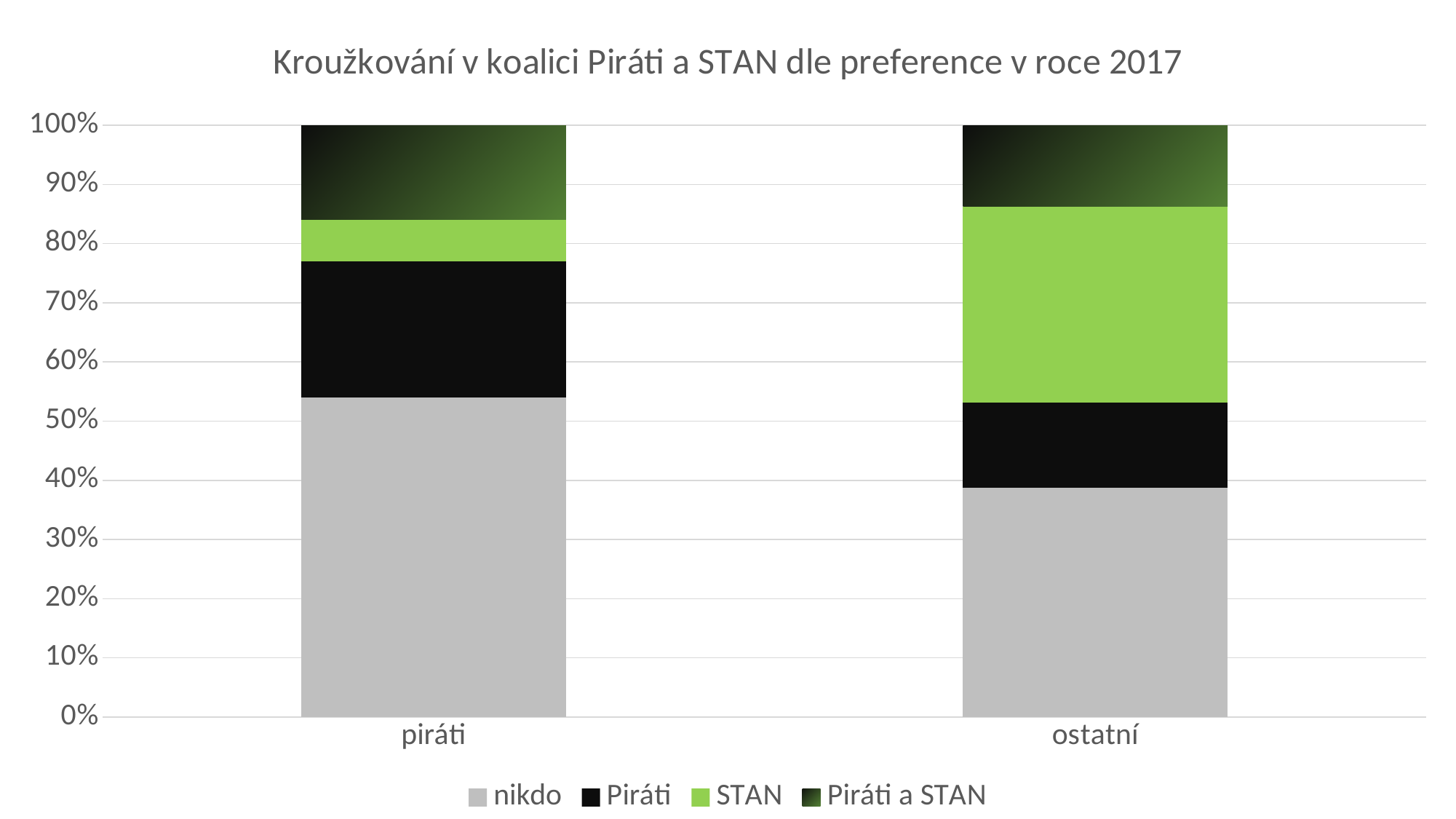
Which series is the largest segment in the piráti bar? nikdo How many series does the legend list? 4 Which category has the larger STAN share, piráti or ostatní? ostatní Is the nikdo share for ostatní greater or less than 30%? greater Which category has the larger Piráti share, piráti or ostatní? piráti Which series is shown in grey in the legend? nikdo What is the title of the chart? Kroužkování v koalici Piráti a STAN dle preference v roce 2017 How many categories are shown on the x axis? 2 What kind of chart is shown on the slide? Stacked bar chart Is the nikdo share for ostatní greater or less than 50%? less Is the nikdo share for piráti greater or less than 50%? greater Which category has the larger nikdo share, piráti or ostatní? piráti